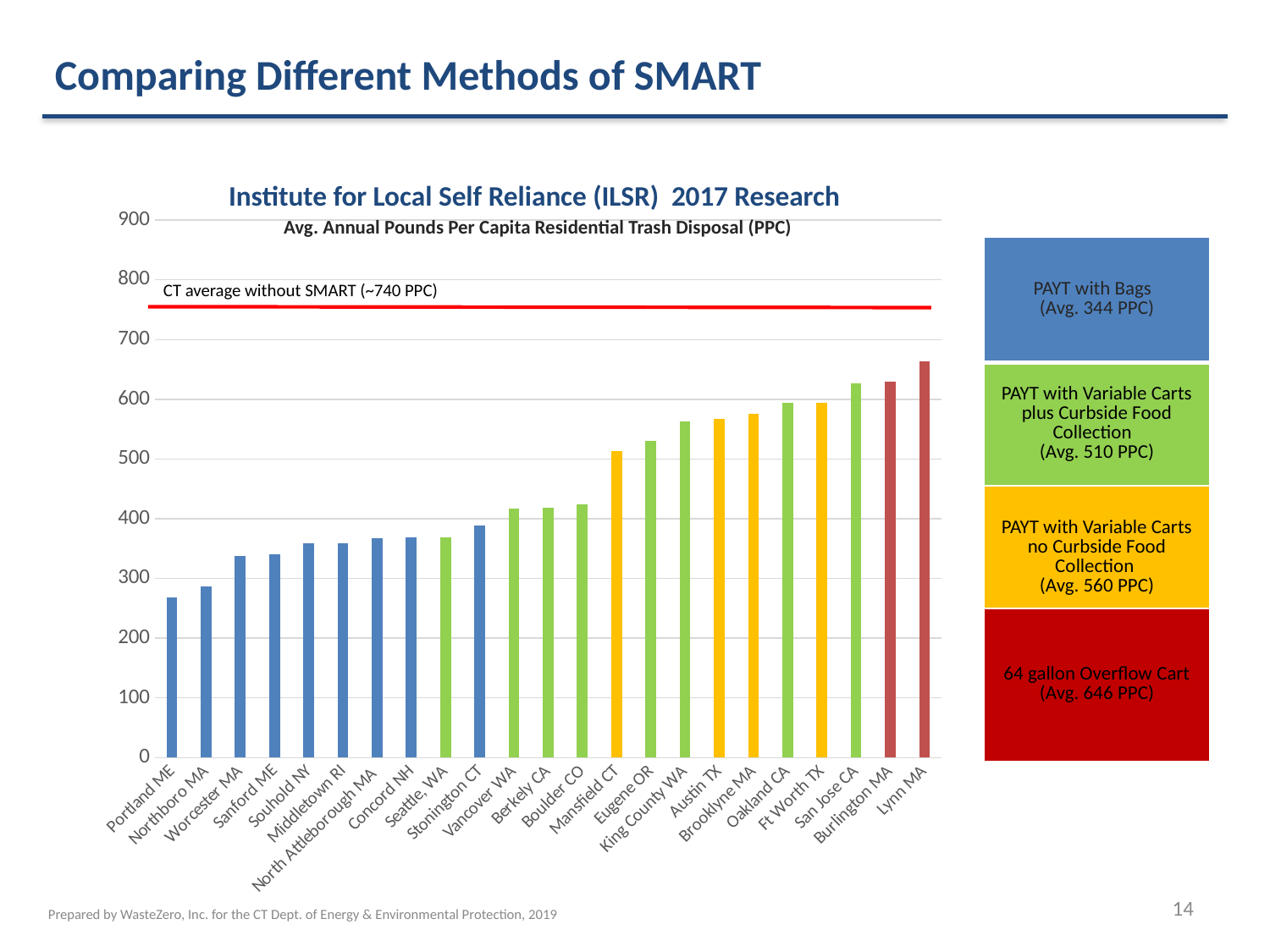
Which has a higher value, Seattle WA or Mansfield CT? Mansfield CT Which city has the highest average annual pounds per capita residential trash disposal? Lynn MA How many cities are plotted on the chart? 23 Is the value for Portland ME greater or less than 300? less Do the bar values rise or fall moving from left to right along the x axis? rise Is the value for Lynn MA greater or less than 700? less Which city has the lowest average annual pounds per capita residential trash disposal? Portland ME Is the value for Stonington CT greater or less than 400? less What kind of chart is shown on the slide? bar chart According to the legend, which SMART method do the red bars represent? 64 gallon Overflow Cart